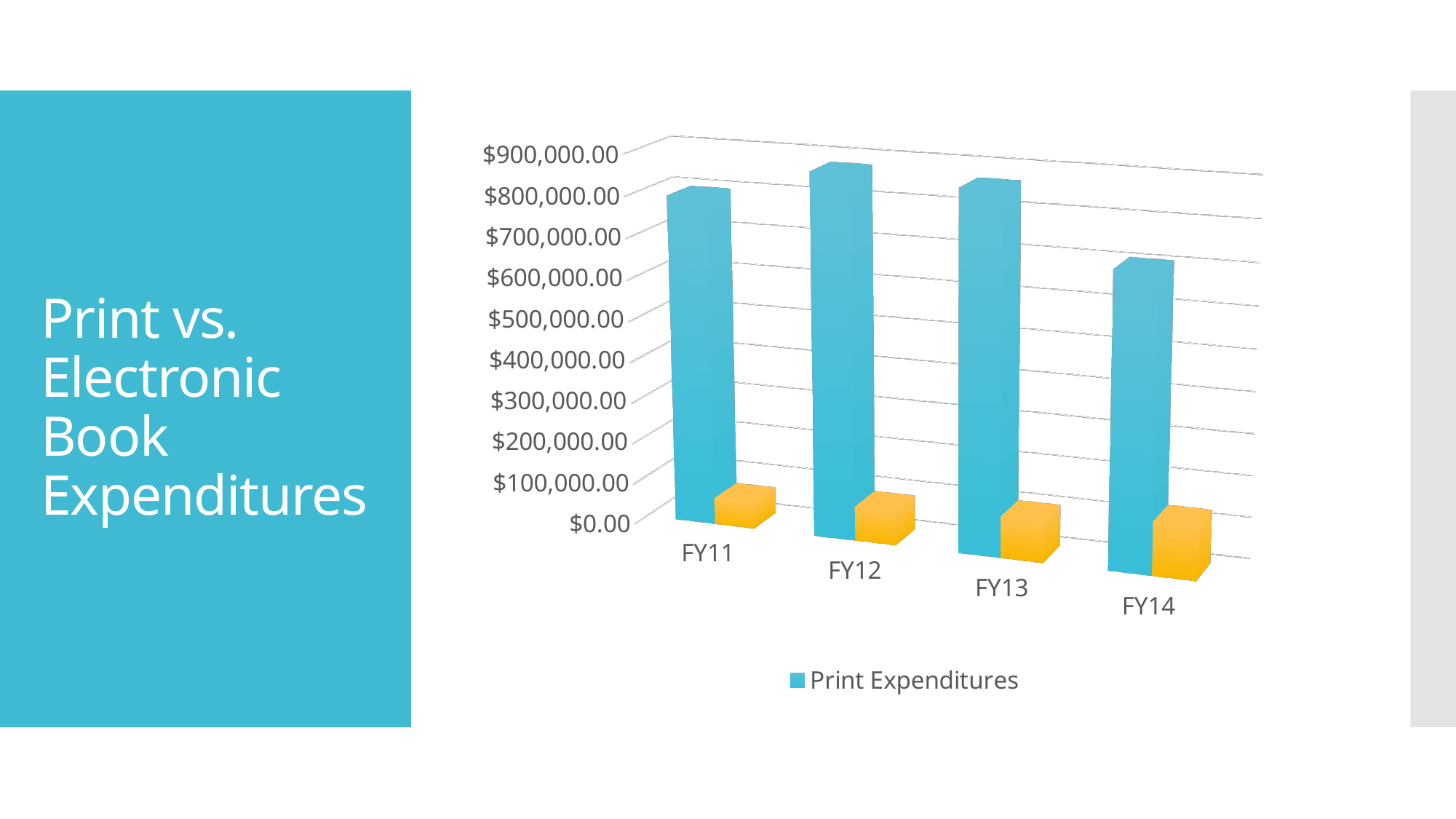
Which fiscal year has the highest Print Expenditures? FY12 What type of chart is shown on the slide? bar chart How many series does the chart's legend list? 1 Which series is shown in blue according to the legend? Print Expenditures Do Print Expenditures rise or fall from FY13 to FY14? fall Is the value for Print Expenditures in FY13 greater or less than $700,000.00? greater Which is larger, Print Expenditures in FY12 or in FY14? FY12 What is the title of the slide containing the chart? Print vs. Electronic Book Expenditures How many fiscal years are shown on the x axis of the chart? 4 Is the value for Print Expenditures in FY12 greater or less than $800,000.00? greater Which fiscal year has the lowest Print Expenditures? FY14